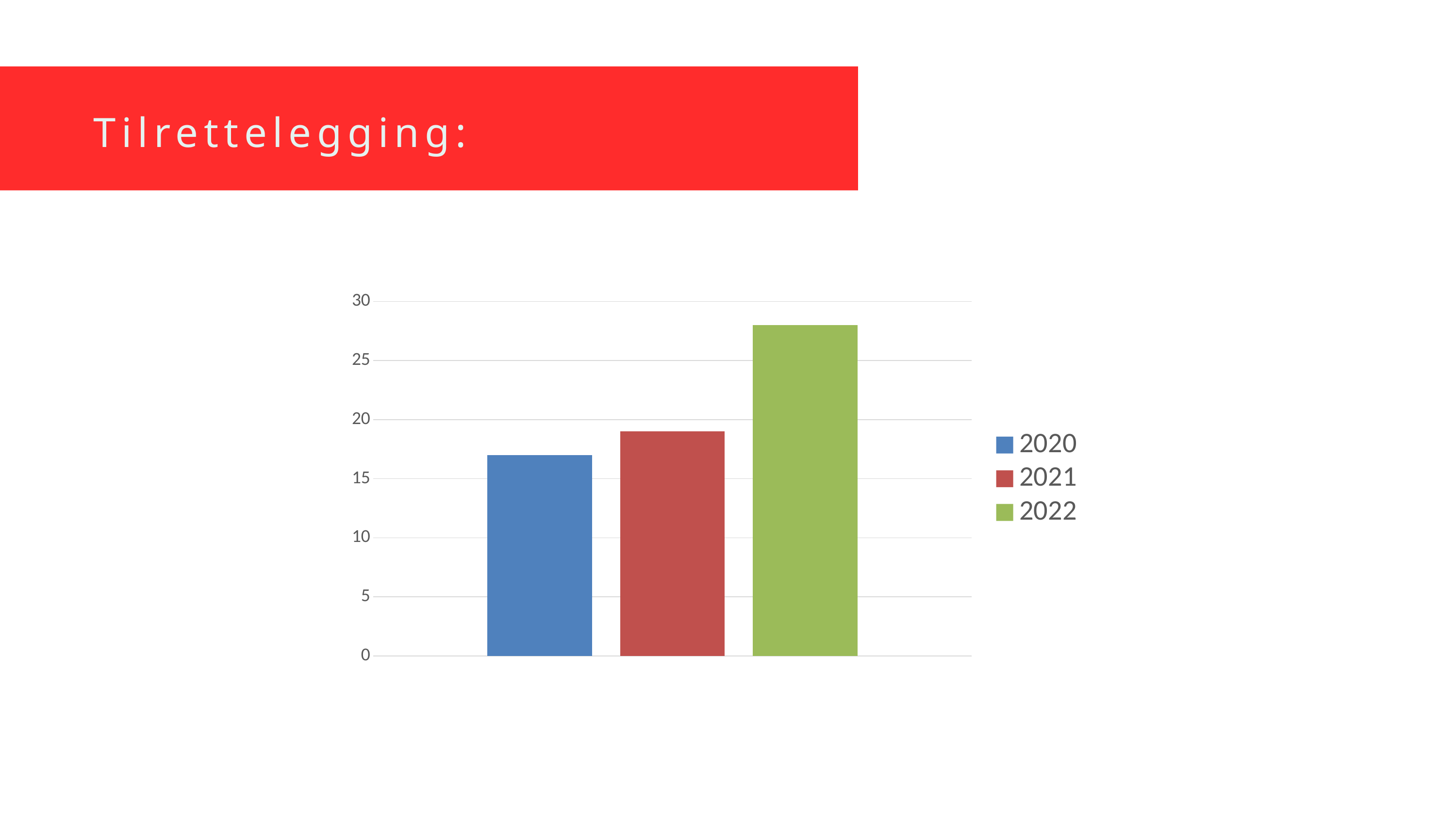
Is the value for 2022 greater or less than 30? less Is the value for 2020 greater or less than 20? less Which year has the highest bar? 2022 How many series does the legend list? 3 What colour is the bar for 2022 in the legend? green Is the value for 2022 greater or less than 25? greater Do the bar values rise or fall from 2020 to 2022? rise Which year has the lowest bar? 2020 What kind of chart is shown on the slide? bar chart Which is larger, the value for 2021 or the value for 2022? 2022 Which is larger, the value for 2020 or the value for 2021? 2021